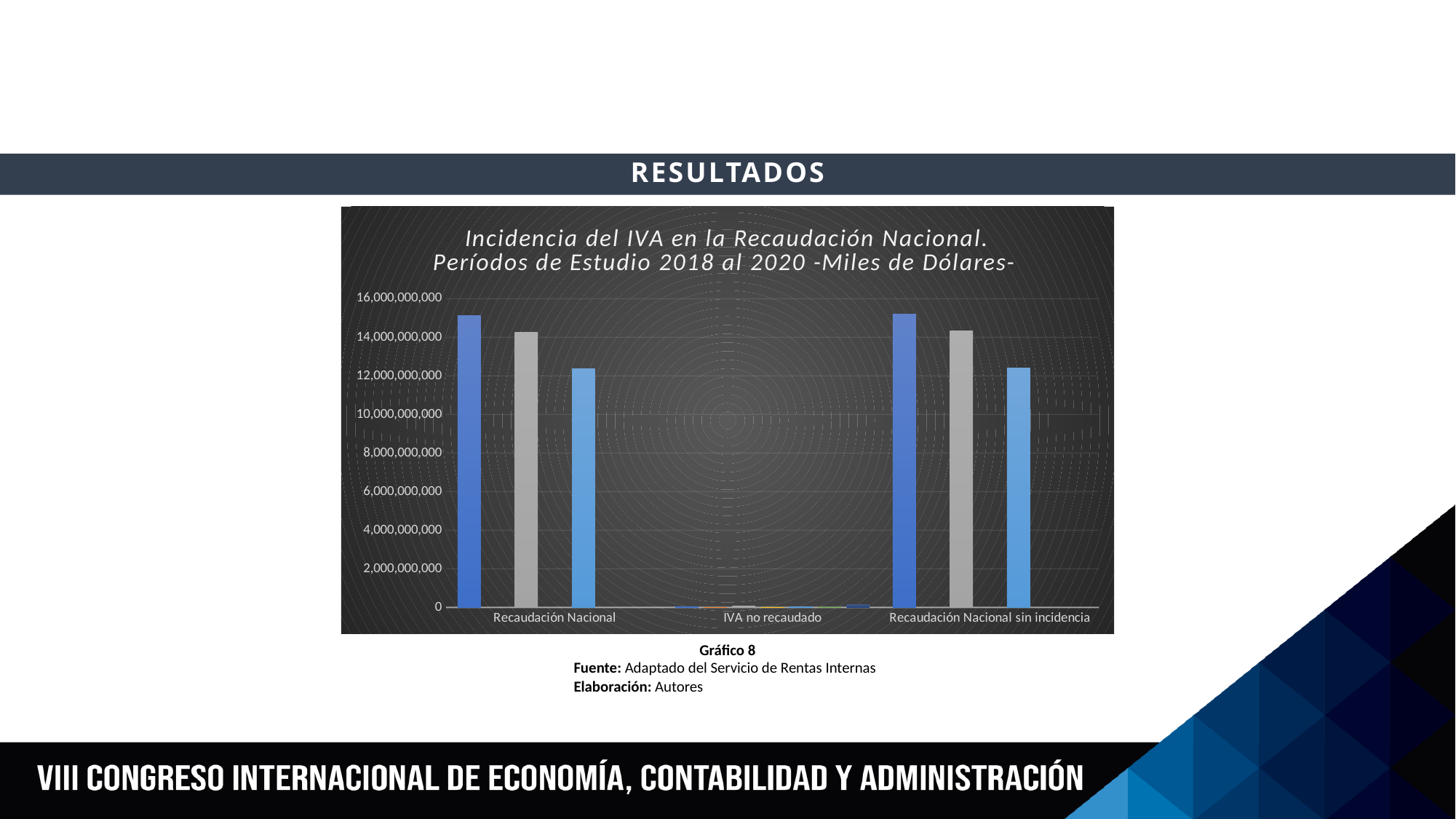
Is the value of the gray bar for Recaudación Nacional sin incidencia greater or less than 12,000,000,000? greater Are the bars for IVA no recaudado greater or less than 2,000,000,000? less Is the value of the tallest (dark blue) bar for Recaudación Nacional greater or less than 14,000,000,000? greater How many categories are shown on the x axis of the chart? 3 For Recaudación Nacional, which bar is taller: the dark blue bar or the light blue bar? The dark blue bar What kind of chart is shown on the slide? Bar chart For Recaudación Nacional sin incidencia, which bar is shorter: the gray bar or the light blue bar? The light blue bar Which category on the x axis has the lowest bars? IVA no recaudado What is the title of the chart? Incidencia del IVA en la Recaudación Nacional. Períodos de Estudio 2018 al 2020 -Miles de Dólares- What is the highest value shown on the y axis of the chart? 16,000,000,000